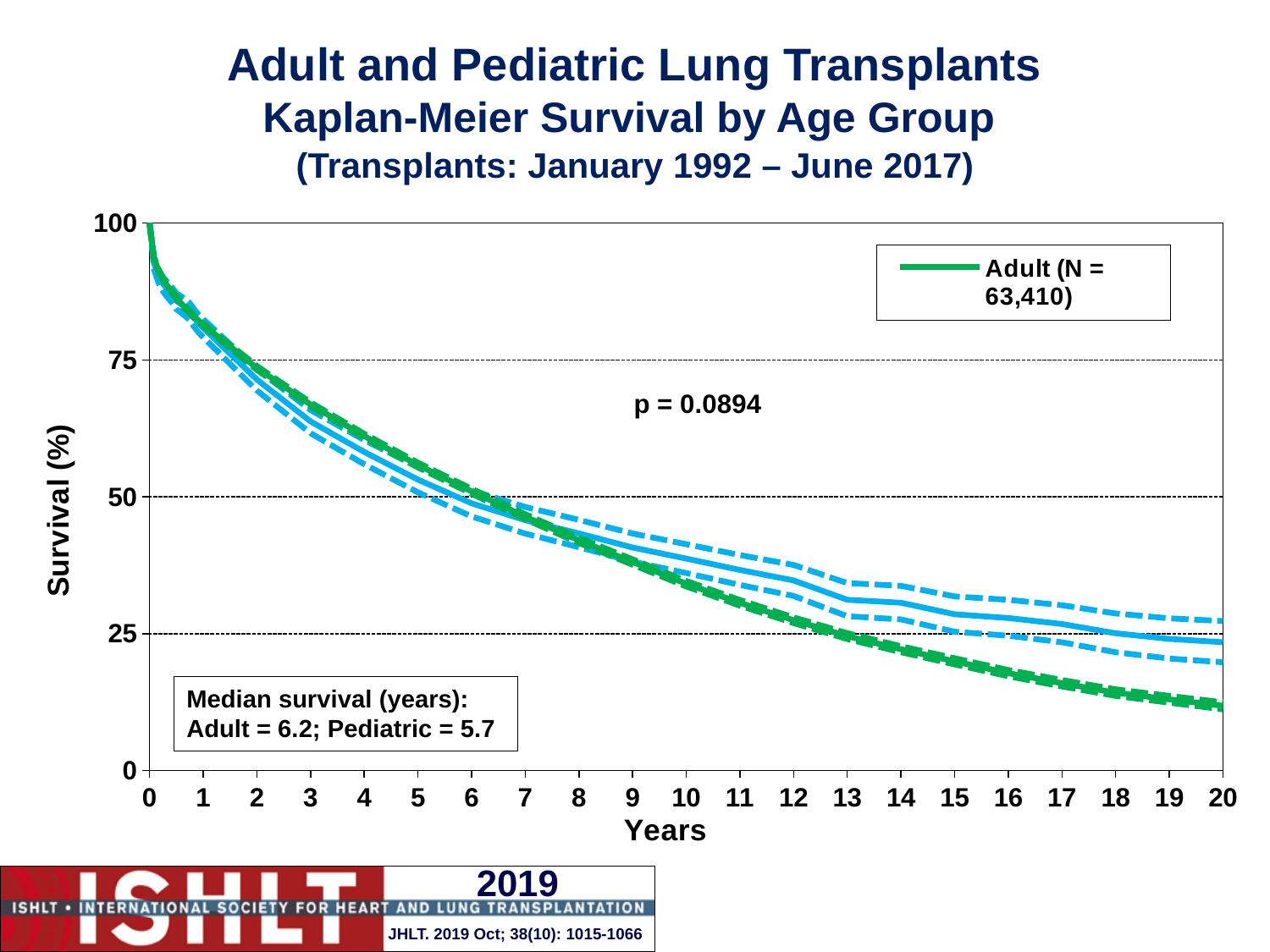
What is the N for the Adult group shown in the legend? 63,410 What p-value is printed on the chart? p = 0.0894 Is the Adult survival value at 5 years greater or less than 50? greater What is the median survival in years for Pediatric recipients? 5.7 Is the Adult survival value at 1 year greater or less than 75? greater What kind of chart is shown on the slide? line chart What is the median survival in years for Adult recipients? 6.2 How many series does the legend list? 1 Does the Adult survival curve rise or fall as years increase? fall What is the difference in median survival (years) between Adult and Pediatric recipients? 0.5 Which group has the longer median survival, Adult or Pediatric? Adult Is the Adult survival value at 20 years greater or less than 25? less